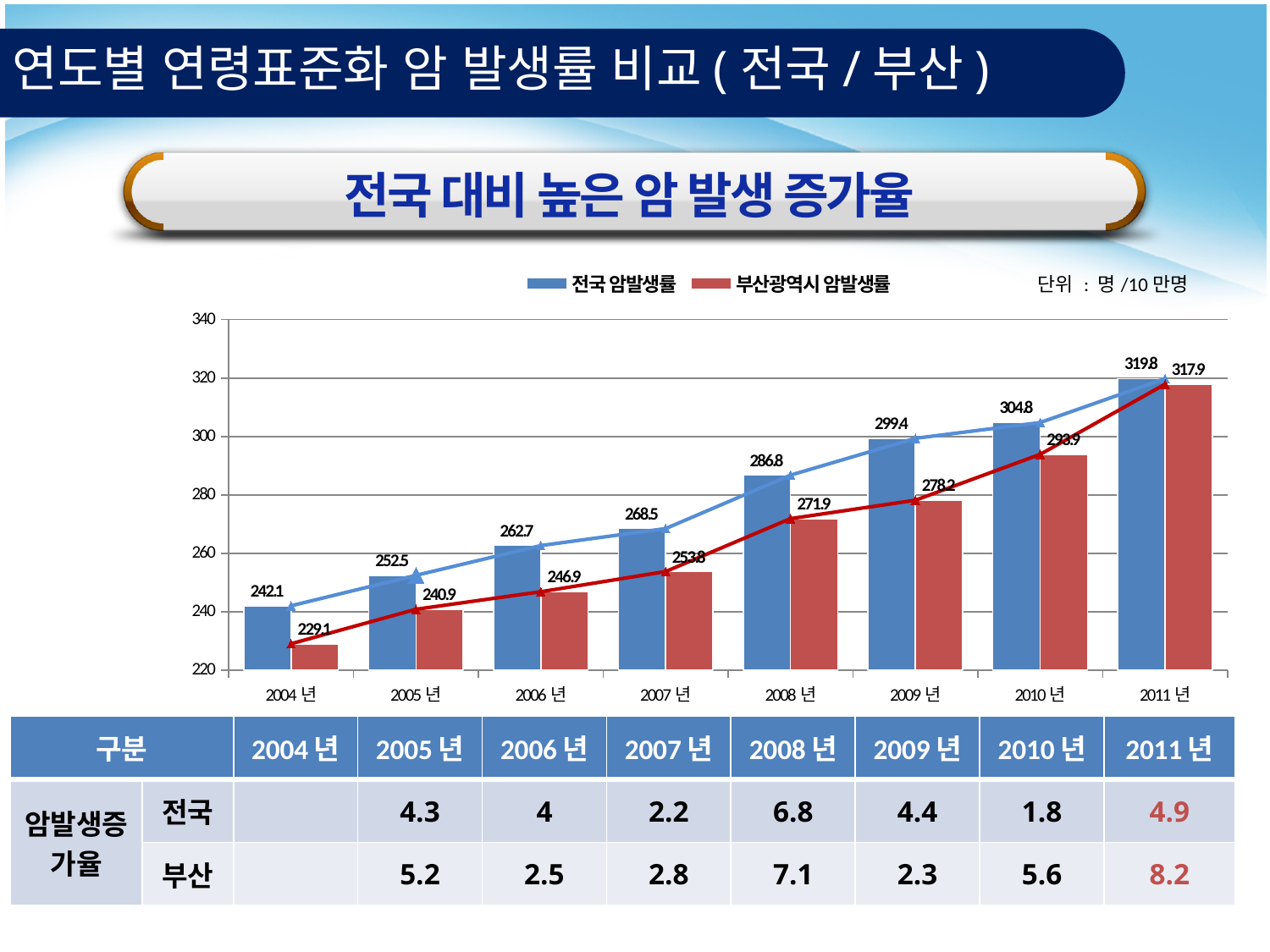
What is the 부산광역시 암발생률 value for 2010 년? 293.9 What is the 전국 암발생률 value for 2008 년? 286.8 What unit is stated for the chart values? 명 /10 만명 Does the 전국 암발생률 value rise or fall from 2004 년 to 2011 년? rise Which is larger in 2009 년, the 전국 암발생률 value or the 부산광역시 암발생률 value? 전국 암발생률 What is the difference between the 전국 암발생률 and 부산광역시 암발생률 values in 2004 년? 13.0 Is the 부산광역시 암발생률 value for 2007 년 greater or less than 260? less What is the 부산광역시 암발생률 value for 2004 년? 229.1 How many years are shown on the x axis of the chart? 8 How many series does the chart legend list? 2 Which year has the highest 전국 암발생률 value? 2011 년 Which year has the lowest 부산광역시 암발생률 value? 2004 년